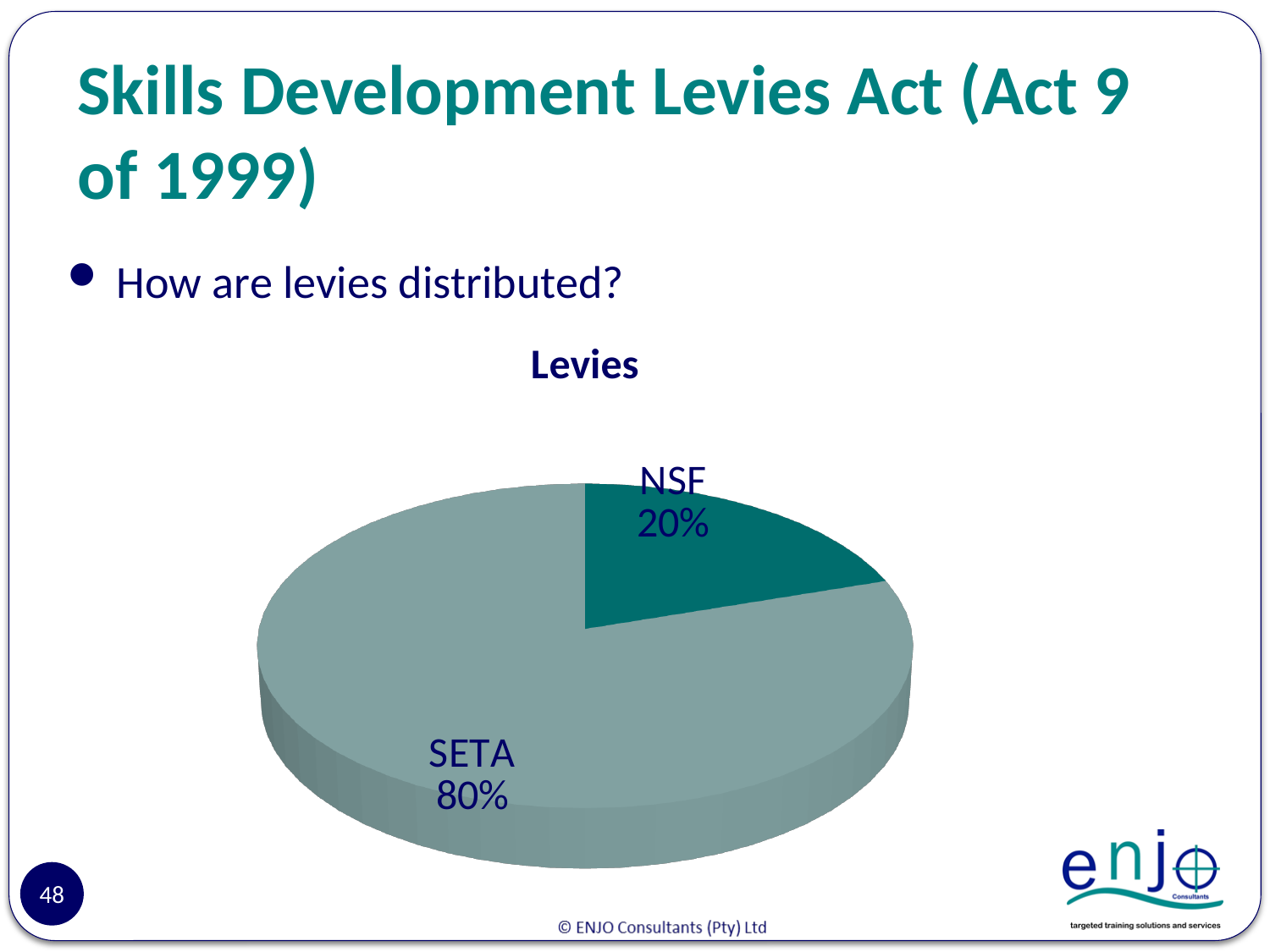
Which receives a larger share of the levies, SETA or NSF? SETA Which category receives the largest share of the levies? SETA How many slices does the pie chart have? 2 Which slice of the pie chart is coloured dark teal? NSF What is the difference in percentage points between the SETA share and the NSF share? 60 percentage points What is the total of the two slices shown in the pie chart? 100% What share of the levies goes to NSF? 20% Which category receives the smallest share of the levies? NSF What share of the levies goes to SETA? 80% What is the title of the chart? Levies What kind of chart is shown on the slide? Pie chart